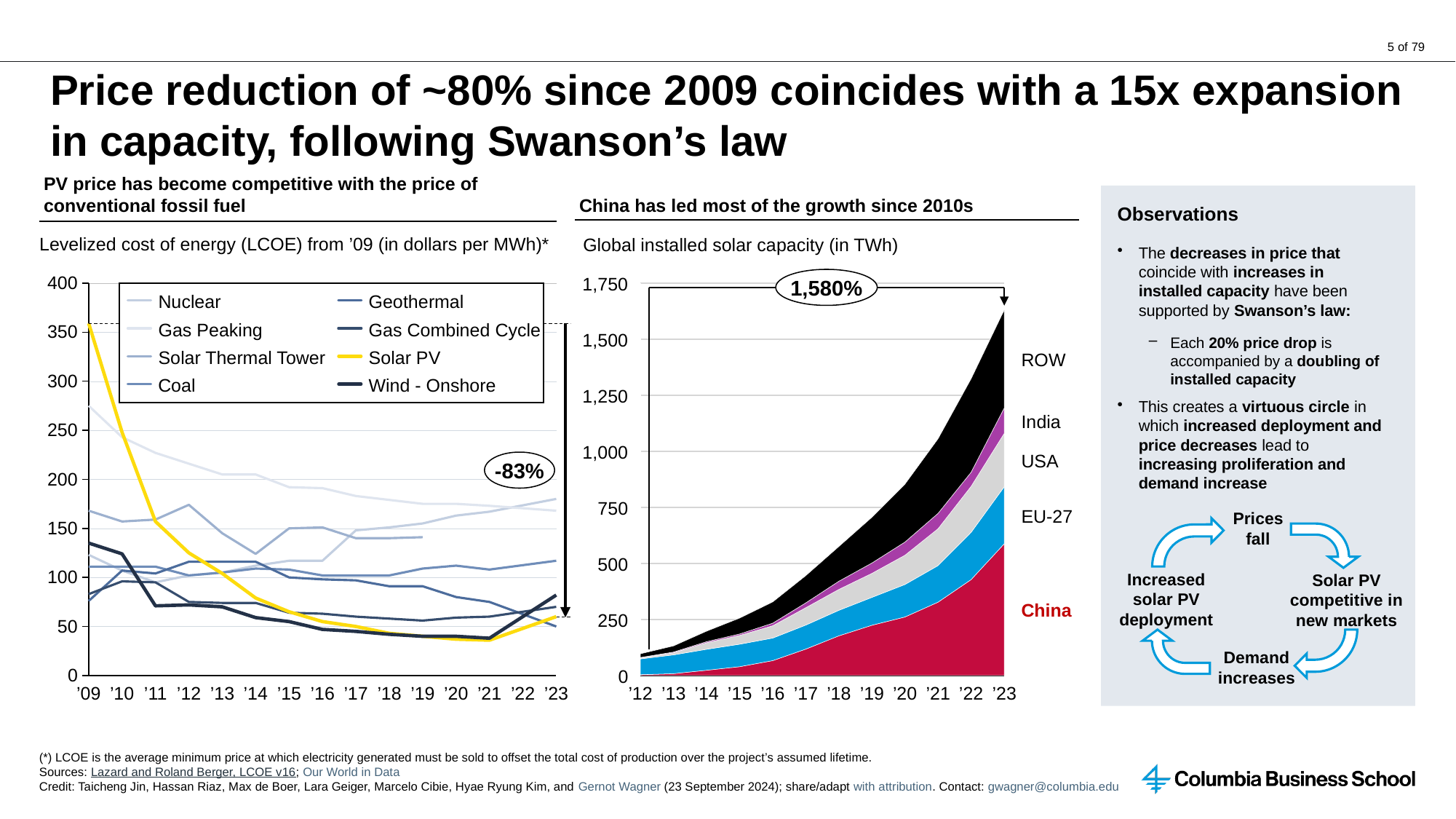
What percentage change is annotated for Solar PV on the left LCOE chart? -83% How many regions are stacked in the right chart, 'Global installed solar capacity'? 5 What percentage growth is annotated on the right chart, 'Global installed solar capacity'? 1,580% What kind of chart is the right chart, 'Global installed solar capacity (in TWh)'? Stacked area chart In the left LCOE chart, which series has the highest value in '09? Solar PV In the left LCOE chart, is the value for Solar PV in '23 greater or less than 100? less In the left LCOE chart, is the value for Solar PV in '09 greater or less than 300? greater What kind of chart is the left chart, 'Levelized cost of energy (LCOE) from '09'? Line chart In the right chart, 'Global installed solar capacity', which region has the largest share in '23? China In the left LCOE chart, does the Solar PV line rise or fall from '09 to '23? Fall How many series does the legend of the left LCOE chart list? 8 How many years are shown on the x axis of the right chart, 'Global installed solar capacity'? 12